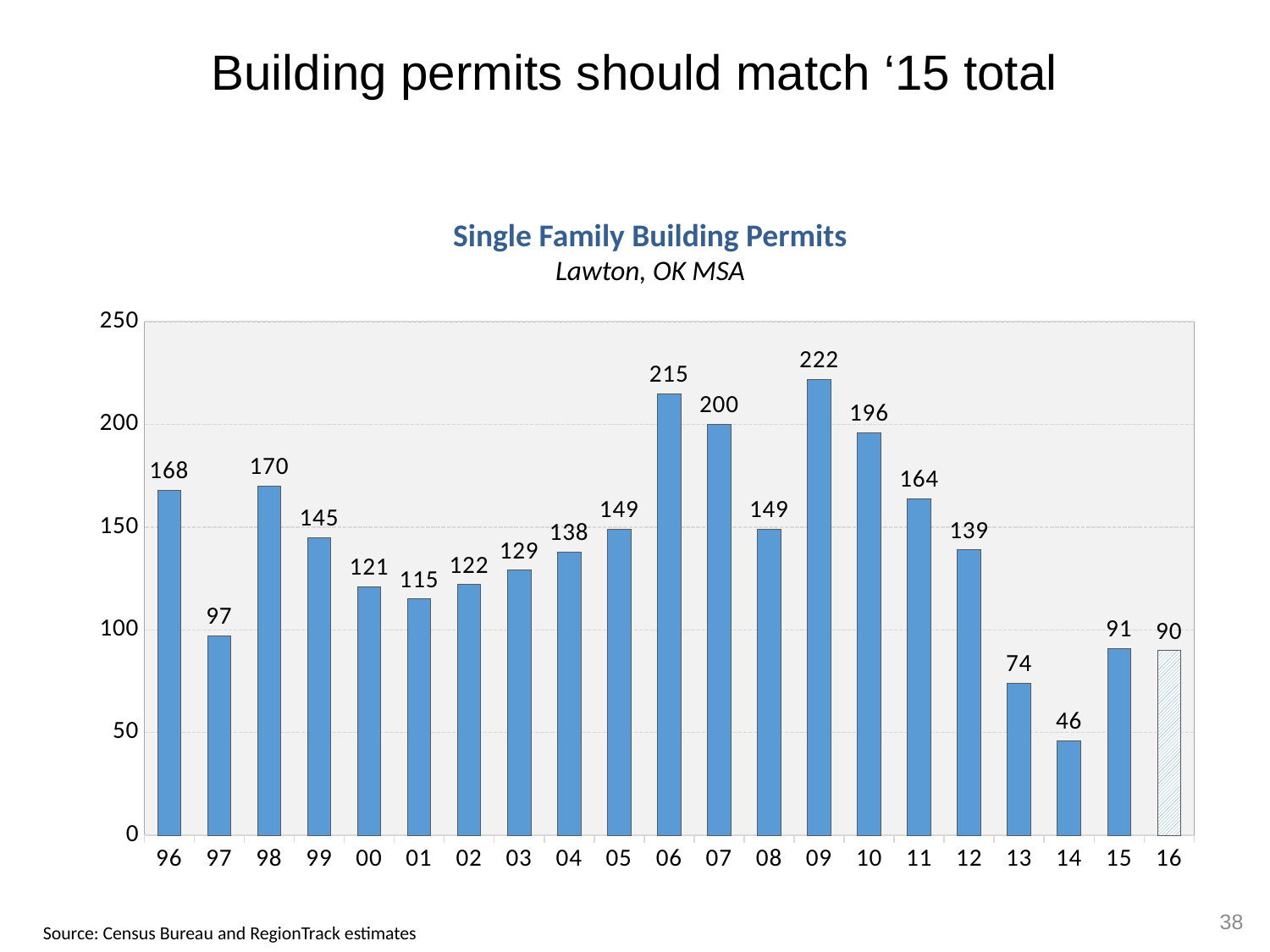
What is the value for 09 in the Single Family Building Permits chart? 222 What kind of chart is the Single Family Building Permits chart? bar chart Which is larger in the Single Family Building Permits chart, the value for 98 or the value for 11? 98 Which year has the highest value in the Single Family Building Permits chart? 09 Which year has the lowest value in the Single Family Building Permits chart? 14 What is the difference between the values for 15 and 16 in the Single Family Building Permits chart? 1 What is the value for 16 in the Single Family Building Permits chart? 90 What is the subtitle shown under the chart title Single Family Building Permits? Lawton, OK MSA How many years are shown on the x axis of the Single Family Building Permits chart? 21 Is the value for 13 greater or less than 100 in the Single Family Building Permits chart? less What is the value for 14 in the Single Family Building Permits chart? 46 What is the difference between the values for 06 and 07 in the Single Family Building Permits chart? 15